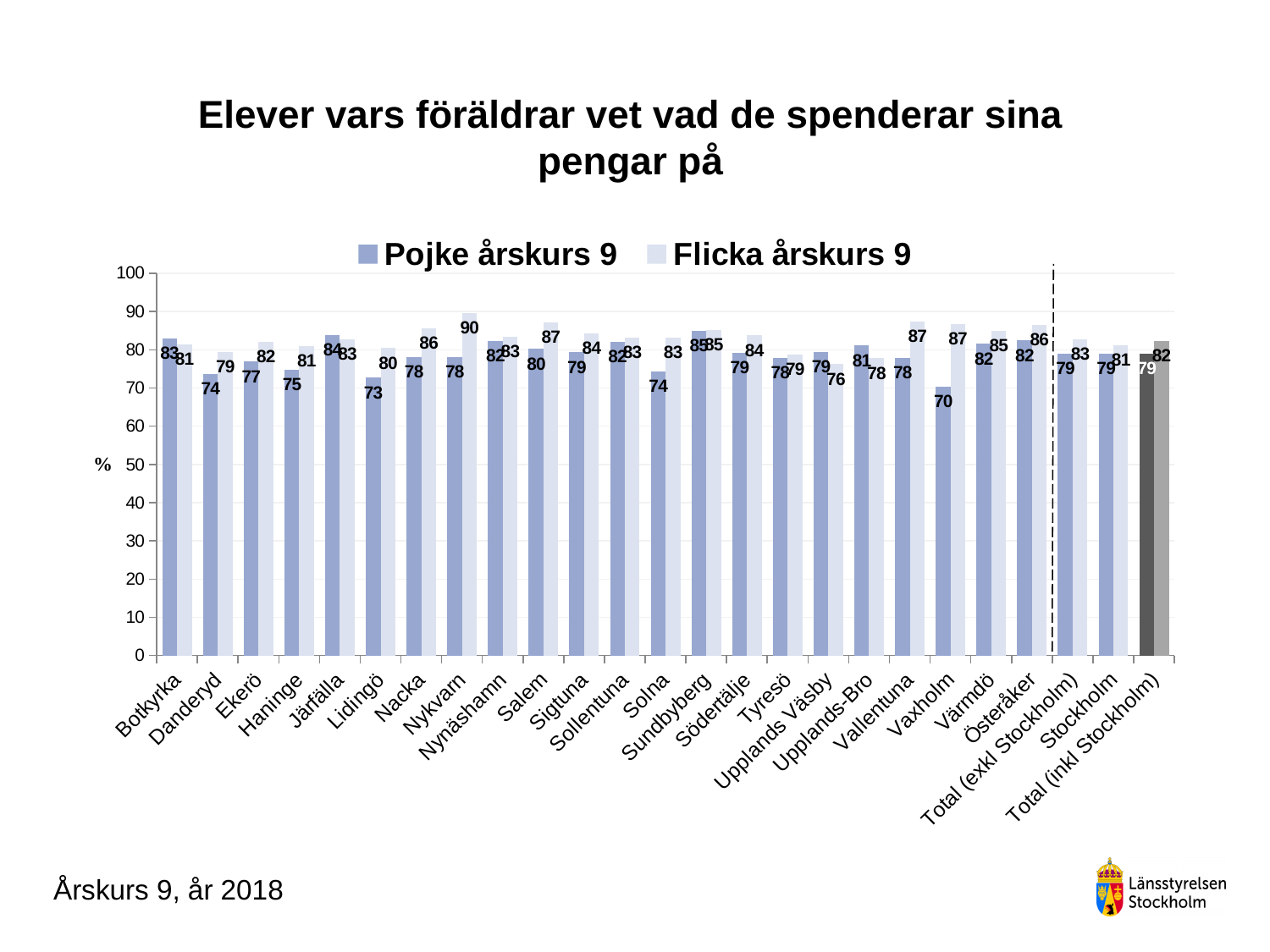
What is the value for Pojke årskurs 9 in Vaxholm? 70 What is the title of the chart? Elever vars föräldrar vet vad de spenderar sina pengar på Which category has the lowest value for Pojke årskurs 9? Vaxholm What kind of chart is shown on the slide? bar chart What is the value for Flicka årskurs 9 in Nykvarn? 90 Which is larger in Upplands Väsby: the Pojke årskurs 9 value or the Flicka årskurs 9 value? Pojke årskurs 9 What is the difference between the Flicka årskurs 9 and Pojke årskurs 9 values in Vaxholm? 17 What is the value for Flicka årskurs 9 in Total (inkl Stockholm)? 82 How many categories are shown on the x axis? 25 Which category has the highest value for Flicka årskurs 9? Nykvarn Is the value for Pojke årskurs 9 in Lidingö greater or less than 80? less How many series does the legend list? 2